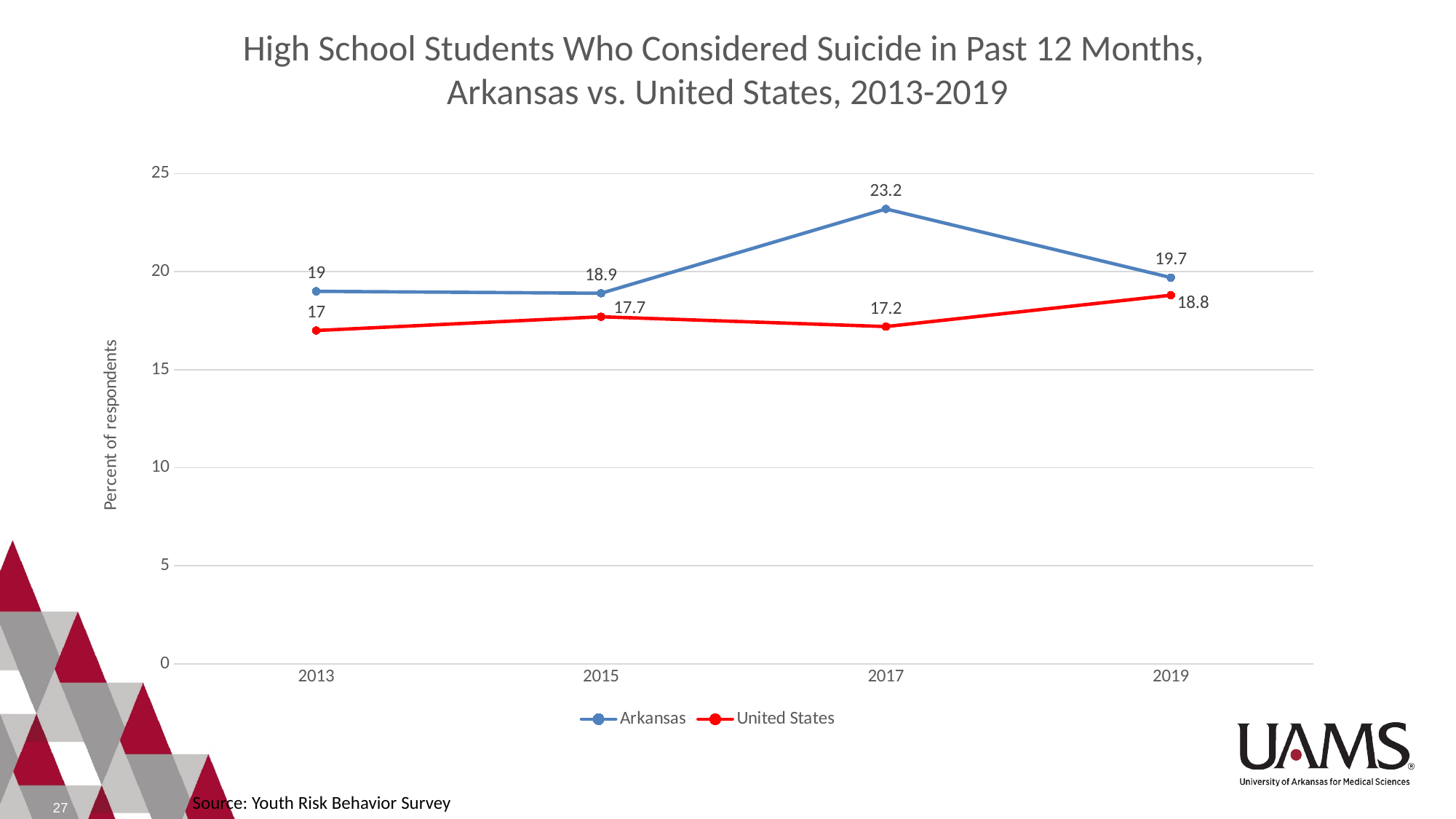
In which year was the Arkansas value highest? 2017 What is the label of the y axis? Percent of respondents Which series had the higher value in 2015, Arkansas or United States? Arkansas How many series does the legend list? 2 How many years are shown on the x axis? 4 What kind of chart is shown on the slide? Line chart In which year was the United States value lowest? 2013 What was the United States value in 2019? 18.8 What was the United States value in 2013? 17 What was the Arkansas value in 2017? 23.2 What is the difference between the Arkansas and United States values in 2017? 6 Did the United States value rise or fall from 2017 to 2019? Rise